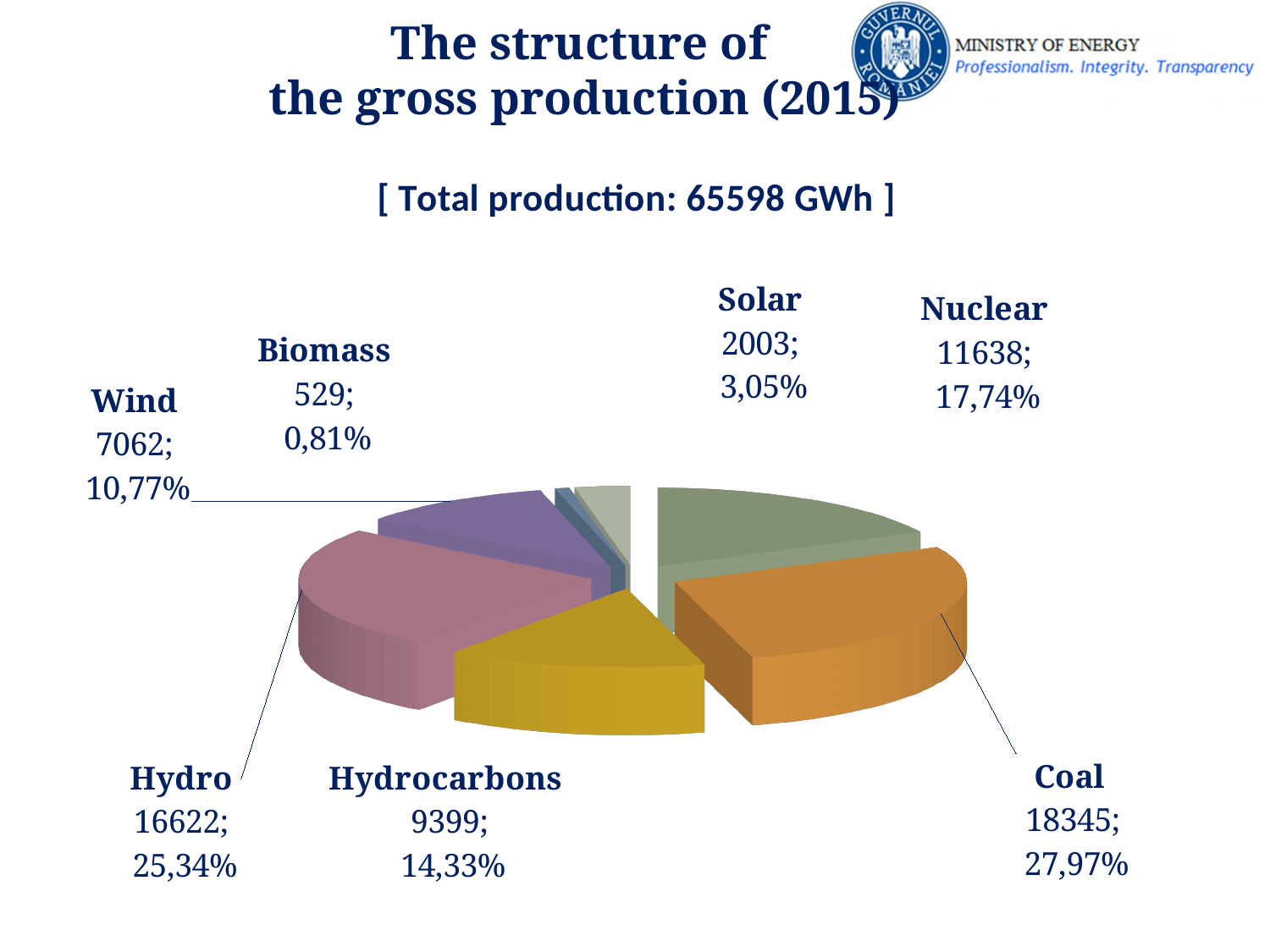
Which category has the largest slice of the pie? Coal Which is larger, the value for Wind or the value for Hydrocarbons? Hydrocarbons What is the production value for Biomass? 529 What share of the pie does Hydro represent? 25,34% How many categories are shown in the pie chart? 7 What share of the pie does Solar represent? 3,05% What is the production value for Nuclear? 11638 What is the production value for Coal? 18345 What total production is stated above the chart? 65598 GWh What kind of chart is shown on the slide? pie chart What is the difference between the Coal and Hydro production values? 1723 Which category has the smallest slice of the pie? Biomass